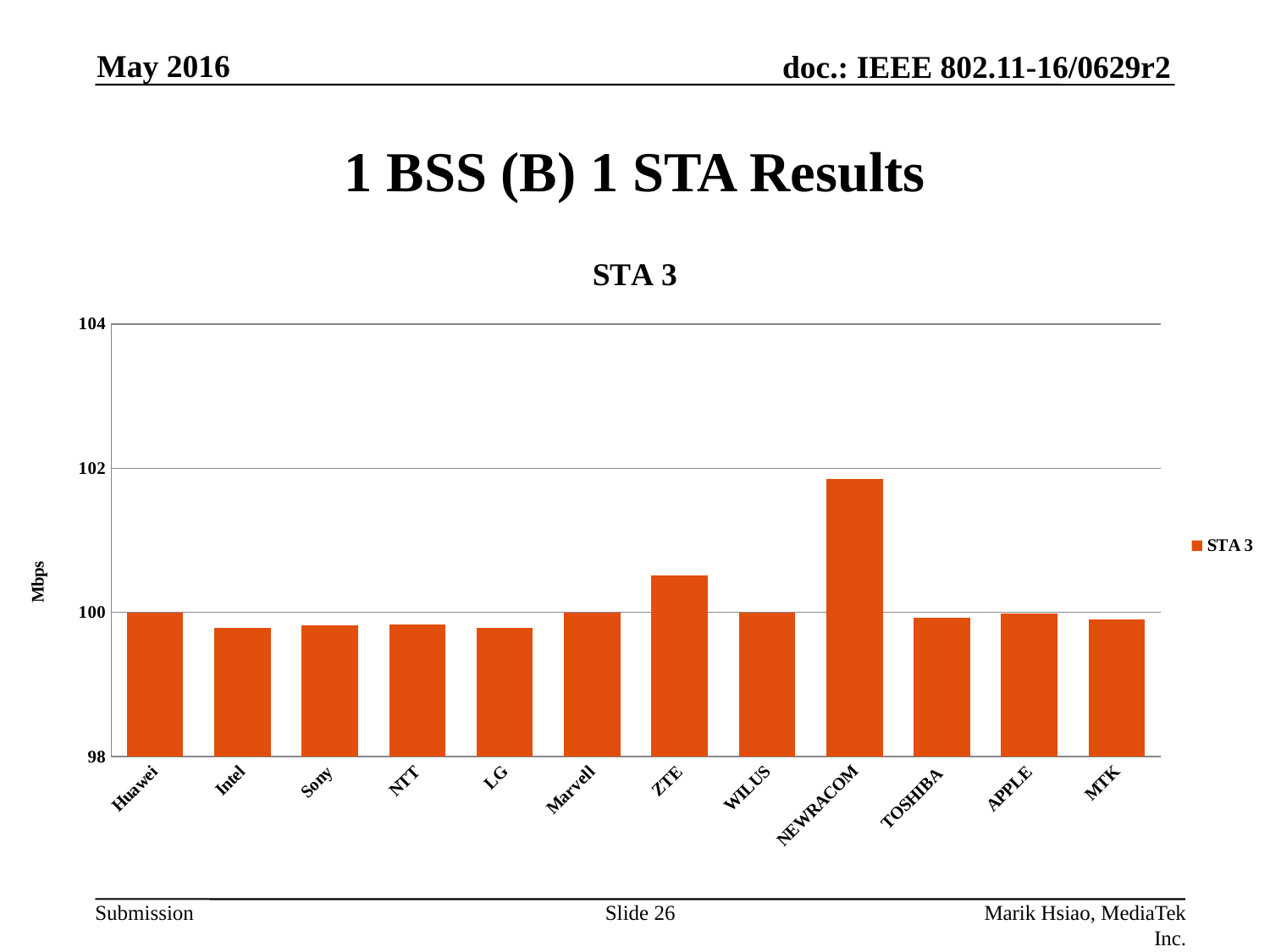
Is the value for Intel greater or less than 100? less Is the value for ZTE greater or less than 100? greater How many series does the legend list? 1 Is the value for NEWRACOM greater or less than 102? less What is the title of the chart? STA 3 Which is larger, the value for ZTE or the value for LG? ZTE Which is larger, the value for NEWRACOM or the value for ZTE? NEWRACOM Which category has the highest value in the chart? NEWRACOM What unit is shown on the y axis label of the chart? Mbps What kind of chart is shown on the slide? bar chart How many categories are shown on the x axis of the chart? 12